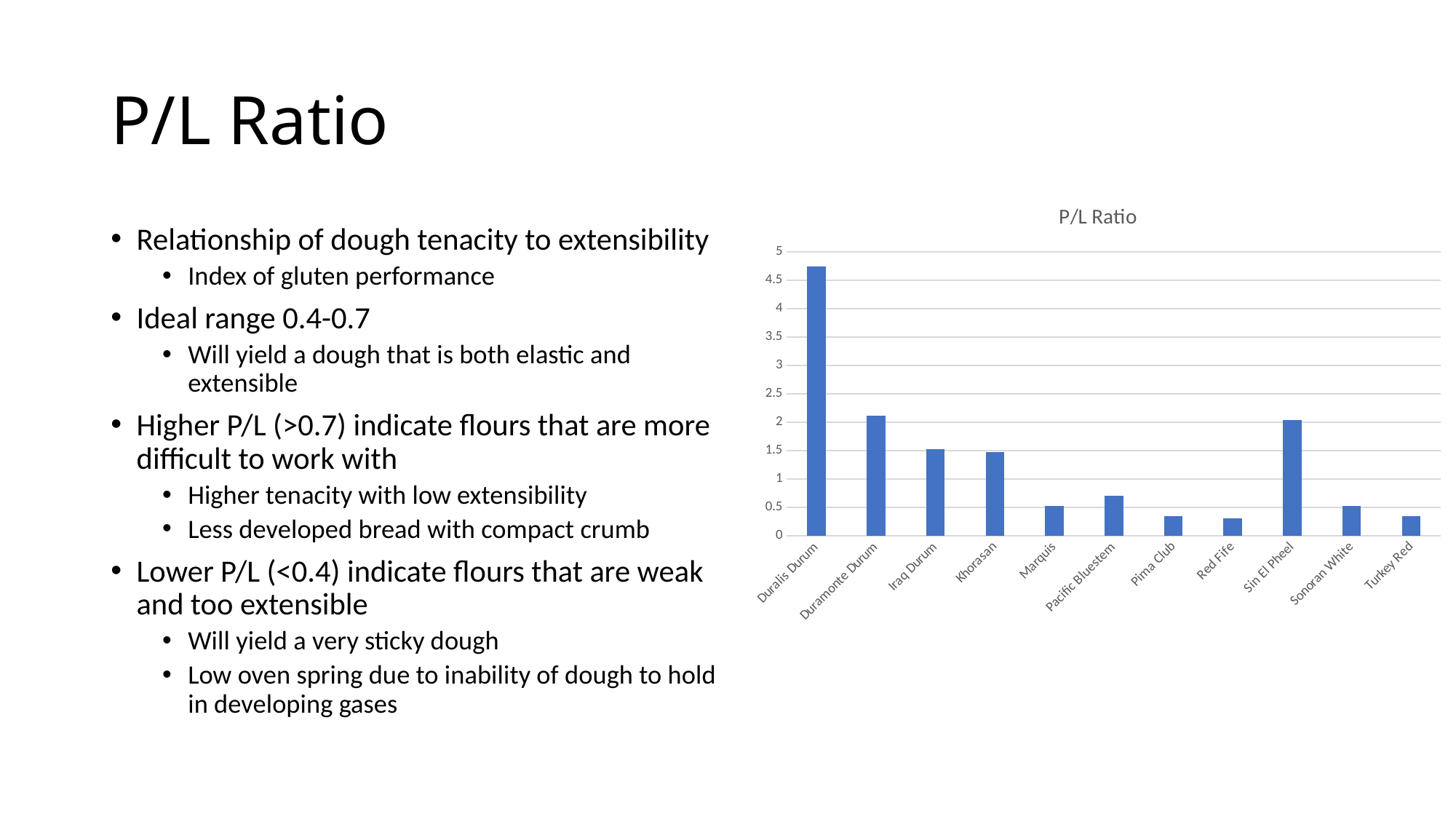
Which variety has the highest P/L ratio? Duralis Durum Is the P/L ratio for Duralis Durum greater or less than 4? greater Which has a higher P/L ratio, Duramonte Durum or Iraq Durum? Duramonte Durum What is the title of the chart? P/L Ratio Is the P/L ratio for Khorasan greater or less than 1? greater Is the P/L ratio for Duramonte Durum greater or less than 2? greater What kind of chart is shown on the slide? bar chart Which has a higher P/L ratio, Pacific Bluestem or Marquis? Pacific Bluestem How many wheat varieties are plotted on the chart? 11 Which has a higher P/L ratio, Sin El Pheel or Khorasan? Sin El Pheel